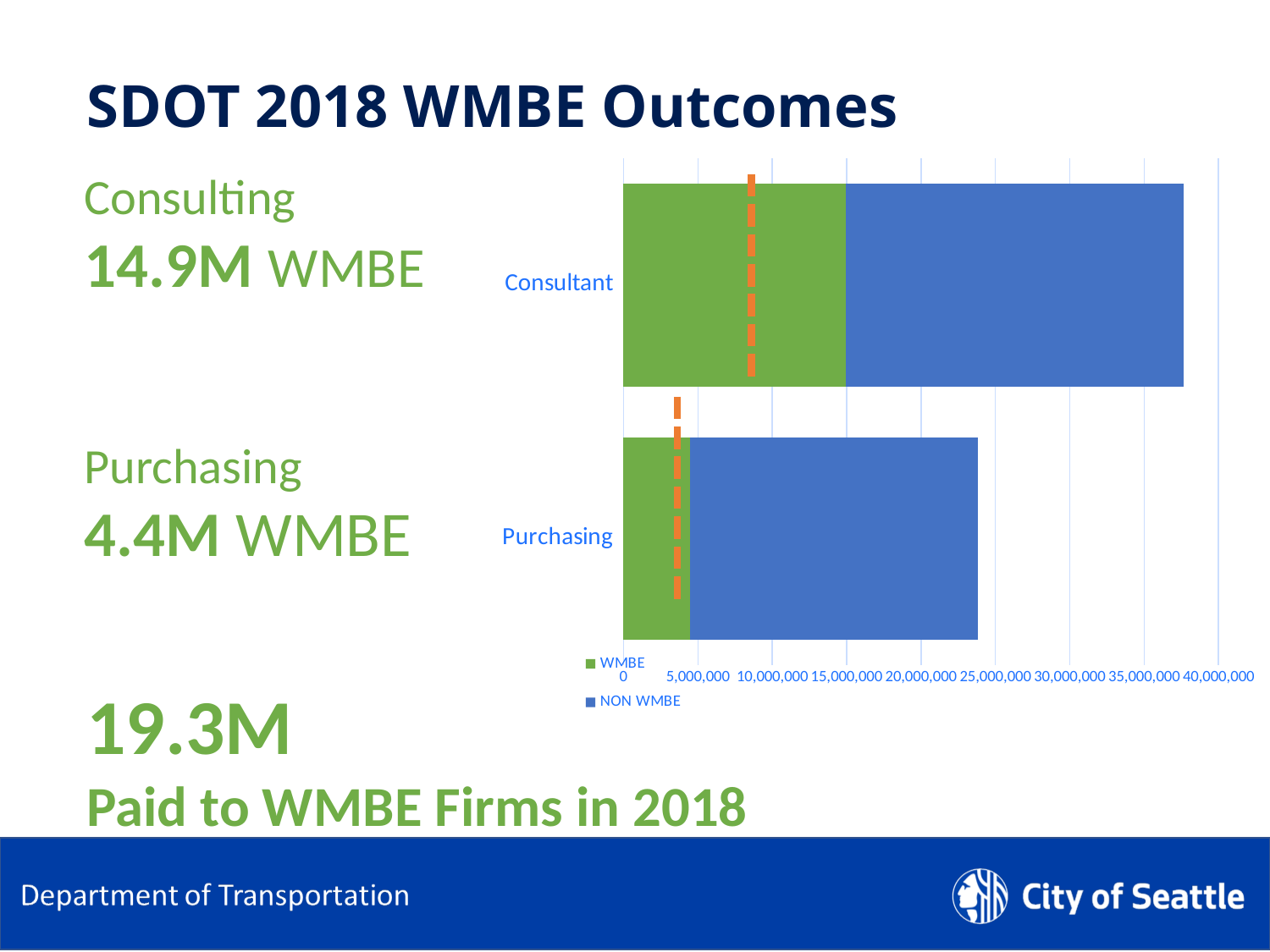
Is the total bar for Consultant greater or less than 35,000,000? greater Which colour represents the NON WMBE series in the chart? blue How many categories are plotted on the chart? 2 Is the WMBE segment for Purchasing greater or less than 5,000,000? less Which category has the longer total bar, Consultant or Purchasing? Consultant Which category has the smallest total bar? Purchasing How many series does the chart legend list? 2 According to the slide, what is the WMBE amount for Purchasing? 4.4M Is the total bar for Purchasing greater or less than 25,000,000? less What kind of chart is shown on the slide? bar chart According to the slide, what is the WMBE amount for Consulting? 14.9M